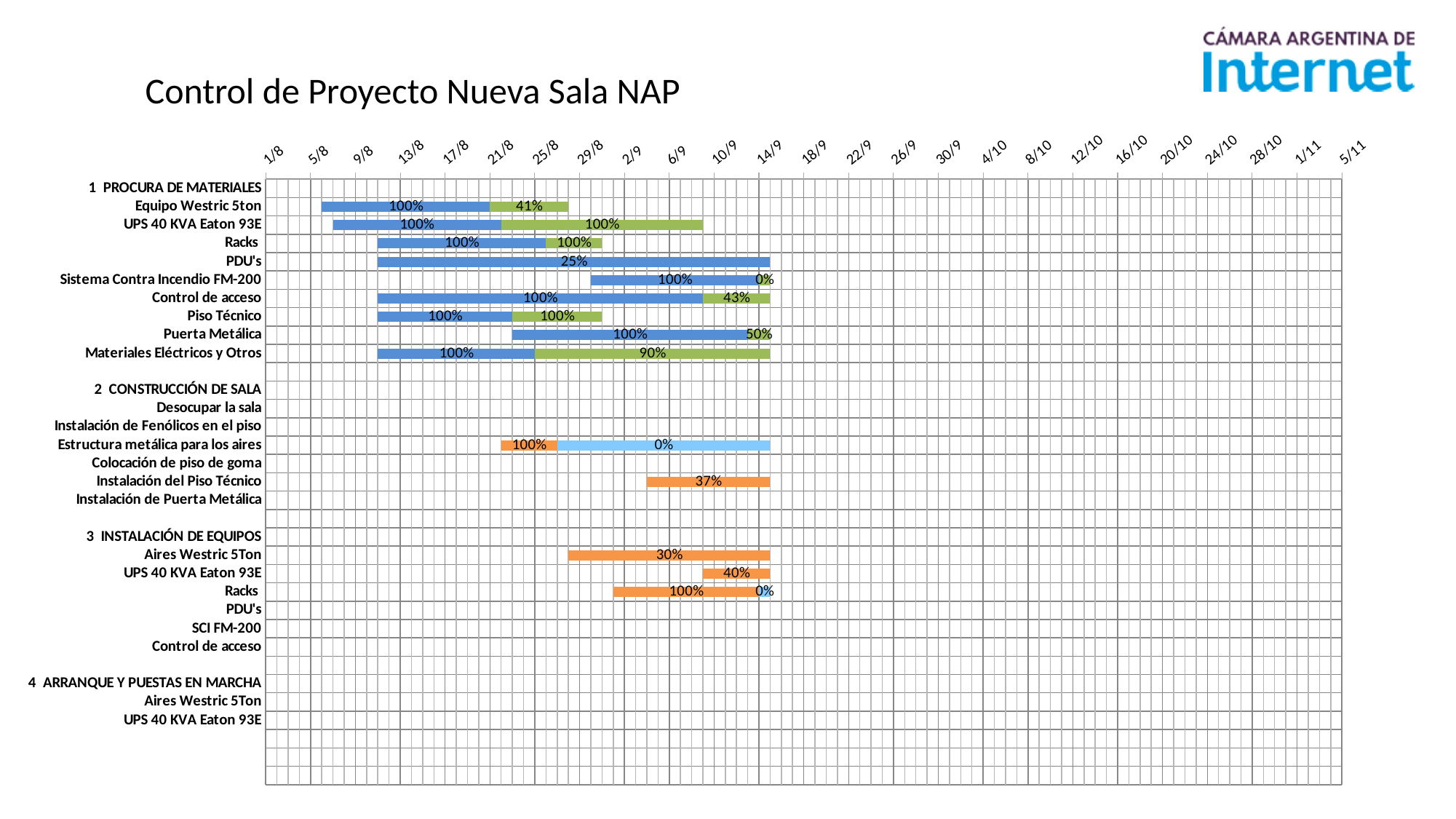
What is the difference between the green bar percentage for Materiales Eléctricos y Otros (90%) and the green bar percentage for Puerta Metálica (50%)? 40% What percentage is shown on the bar for UPS 40 KVA Eaton 93E in section 3 Instalación de Equipos? 40% What percentage is shown on the green bar for Equipo Westric 5ton in section 1 Procura de Materiales? 41% What percentage is shown on the green bar for Control de acceso in section 1 Procura de Materiales? 43% Which task in section 1 Procura de Materiales has the lowest percentage on its green bar? Sistema Contra Incendio FM-200 What kind of chart is shown on the slide? Gantt chart How many main numbered sections are listed on the left of the chart? 4 What percentage is shown on the bar for Aires Westric 5Ton in section 3 Instalación de Equipos? 30% What is the title of the chart? Control de Proyecto Nueva Sala NAP What percentage is shown on the blue bar for PDU's in section 1 Procura de Materiales? 25% What percentage is shown on the bar for Instalación del Piso Técnico in section 2 Construcción de Sala? 37% Which has the higher percentage in section 3 Instalación de Equipos: Aires Westric 5Ton or UPS 40 KVA Eaton 93E? UPS 40 KVA Eaton 93E